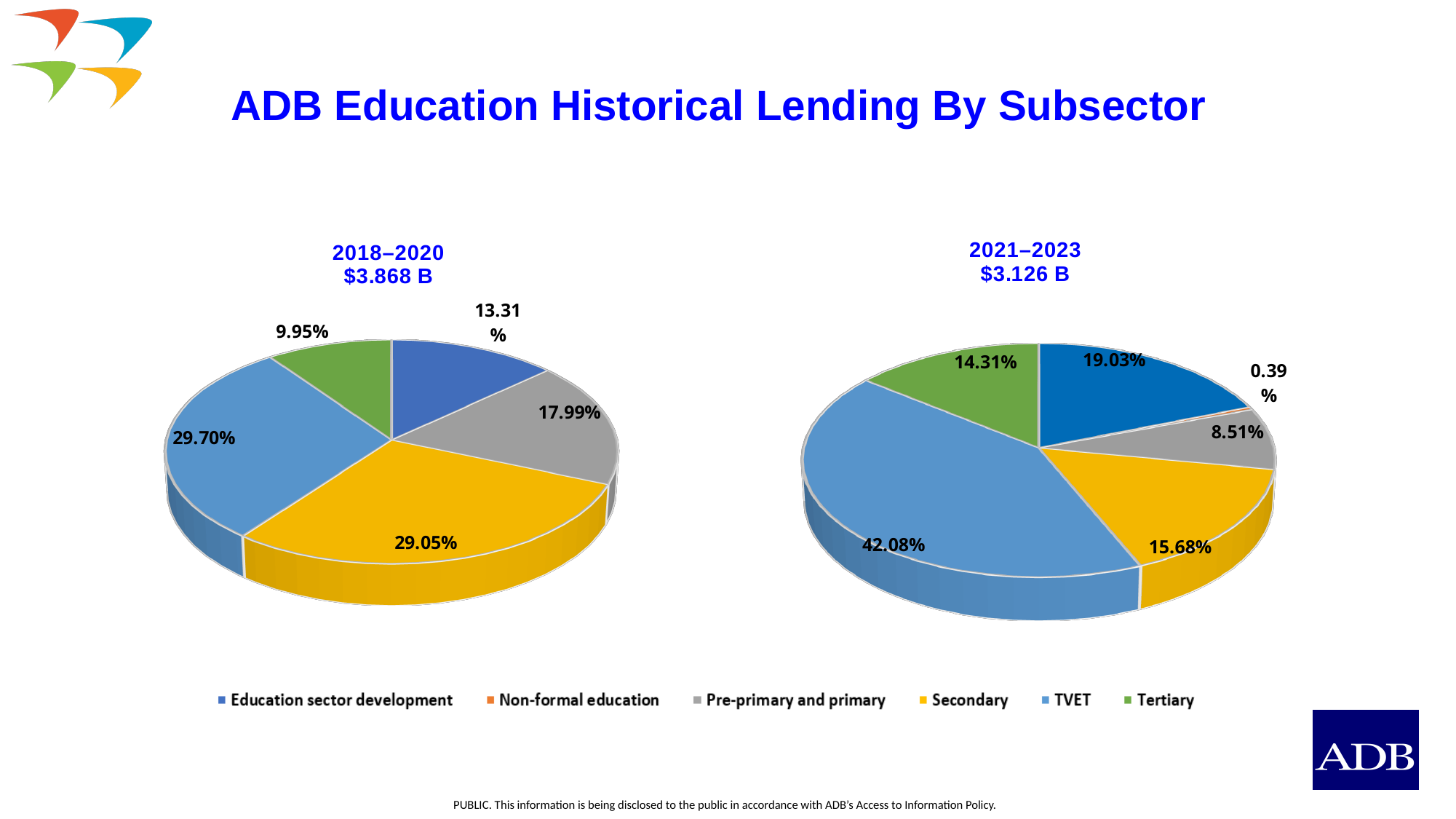
In the 2021–2023 pie chart, which subsector has the smallest share? Non-formal education In the 2018–2020 pie chart, which subsector has the smallest share? Tertiary What type of charts are shown on the slide? Pie charts In the 2018–2020 pie chart, what share of lending went to Secondary? 29.05% What total lending amount is shown for the 2021–2023 pie chart? $3.126 B How many subsectors does the legend list? 6 In the 2021–2023 pie chart, what share of lending went to Non-formal education? 0.39% In the 2018–2020 pie chart, which is larger: the share for Pre-primary and primary or the share for Education sector development? Pre-primary and primary In the 2021–2023 pie chart, what is the difference between the TVET share and the Secondary share? 26.40% In the 2021–2023 pie chart, what share of lending went to TVET? 42.08% In the 2018–2020 pie chart, what share of lending went to TVET? 29.70% In the 2021–2023 pie chart, which subsector has the largest share? TVET